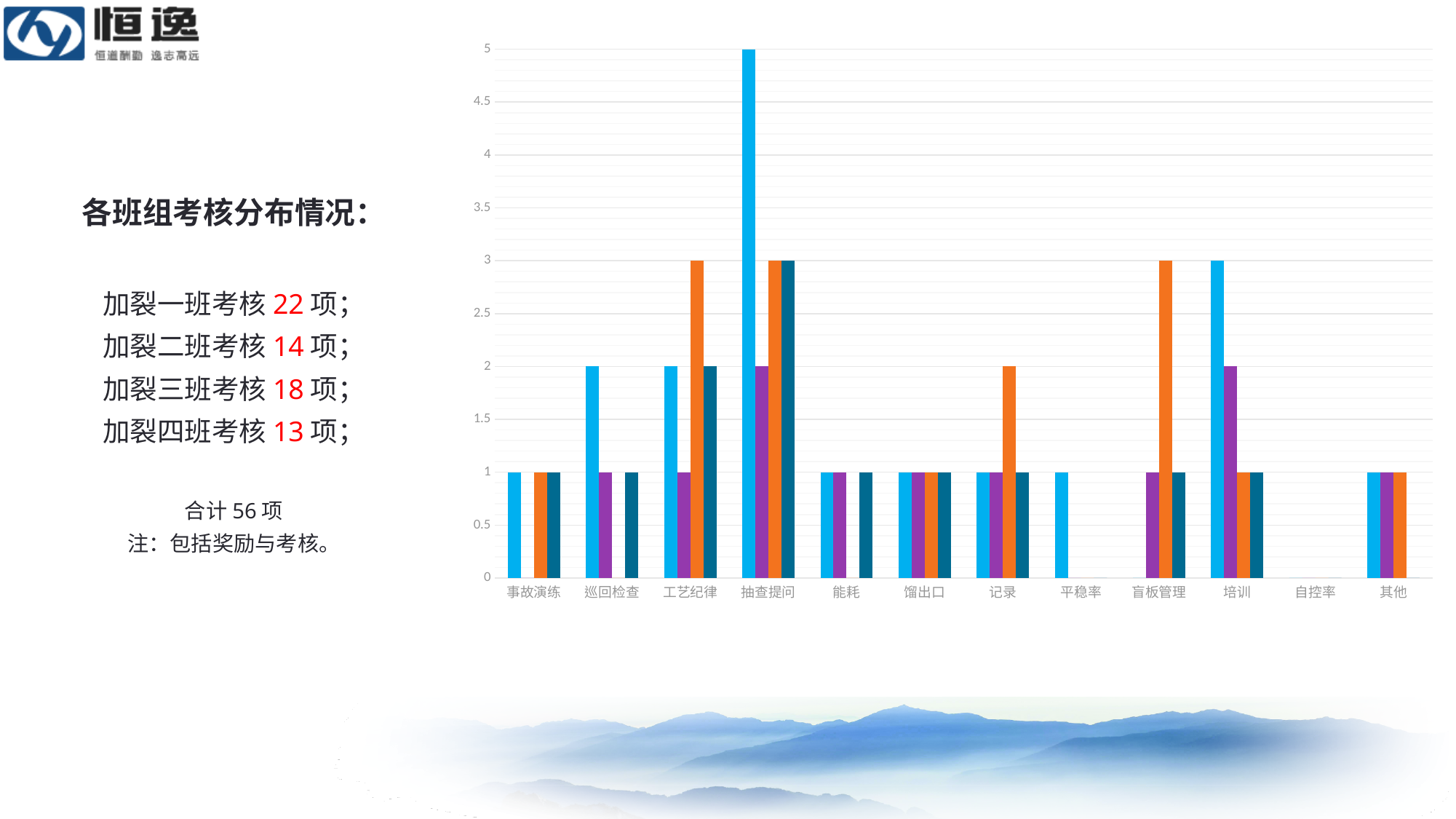
What is the value of the orange bar for 工艺纪律? 3 What kind of chart is shown on the slide? bar chart What is the difference between the light blue bar and the purple bar for 抽查提问? 3 Which category has the tallest bar in the chart? 抽查提问 What is the value of the orange bar for 记录? 2 What is the value of the purple bar for 培训? 2 What is the value of the orange bar for 盲板管理? 3 Is the value of the light blue bar for 抽查提问 greater or less than 4? greater How many categories are shown along the x axis of the chart? 12 Which is larger: the light blue bar for 巡回检查 or the light blue bar for 培训? 培训 Which category on the x axis has no bars at all? 自控率 What is the value of the light blue bar for 抽查提问? 5